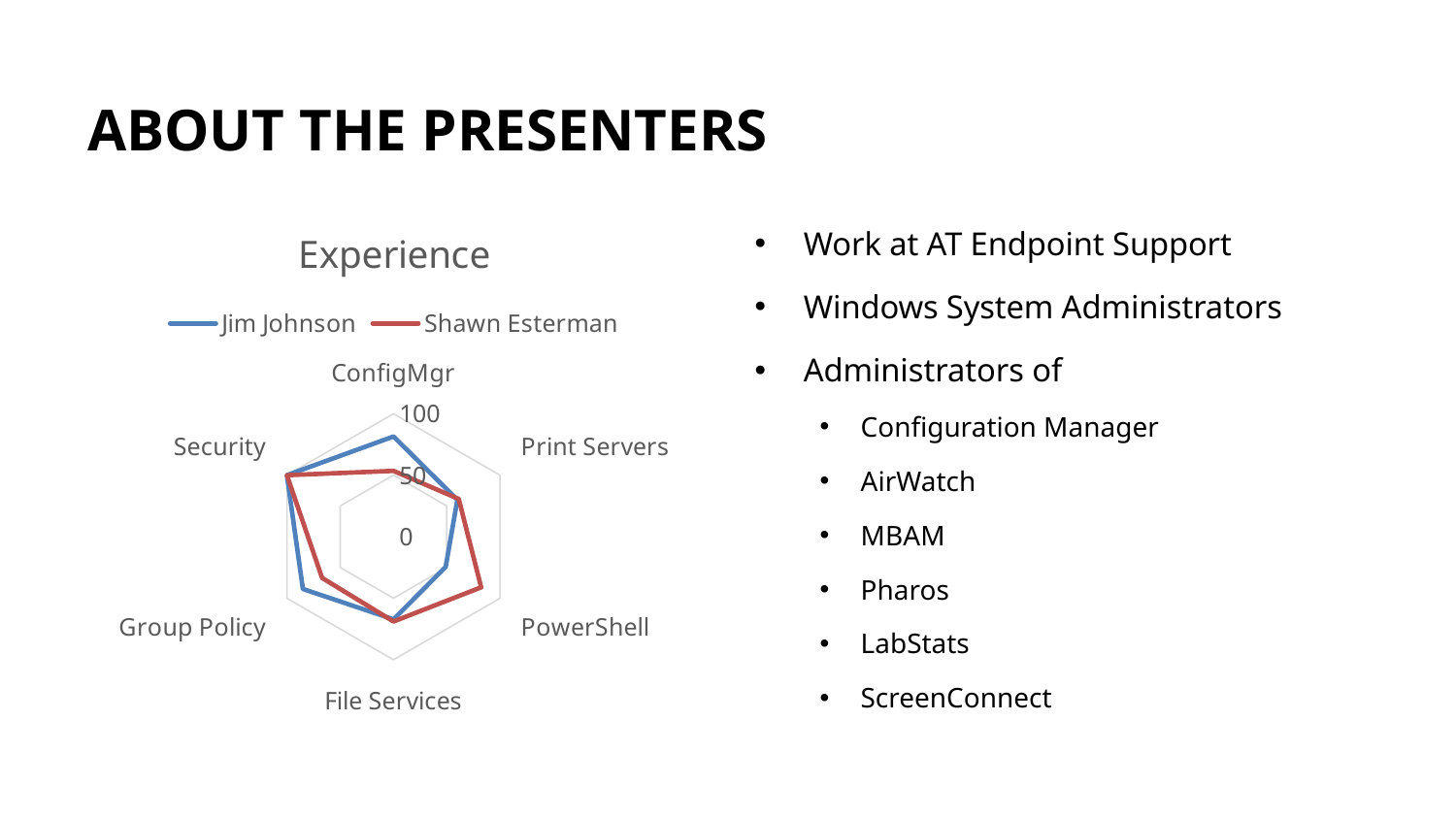
How many categories are plotted on the radar chart? 6 What kind of chart is shown on the slide? Radar chart Is Jim Johnson's value for ConfigMgr greater or less than 50? greater Who has the higher value for PowerShell, Jim Johnson or Shawn Esterman? Shawn Esterman Who has the higher value for ConfigMgr, Jim Johnson or Shawn Esterman? Jim Johnson Is Jim Johnson's value for Group Policy greater or less than 50? greater Which colour represents Shawn Esterman in the chart? Red Is Shawn Esterman's value for PowerShell greater or less than 50? greater What is the title of the chart? Experience How many series does the chart legend list? 2 In which category does Jim Johnson have his lowest value? PowerShell